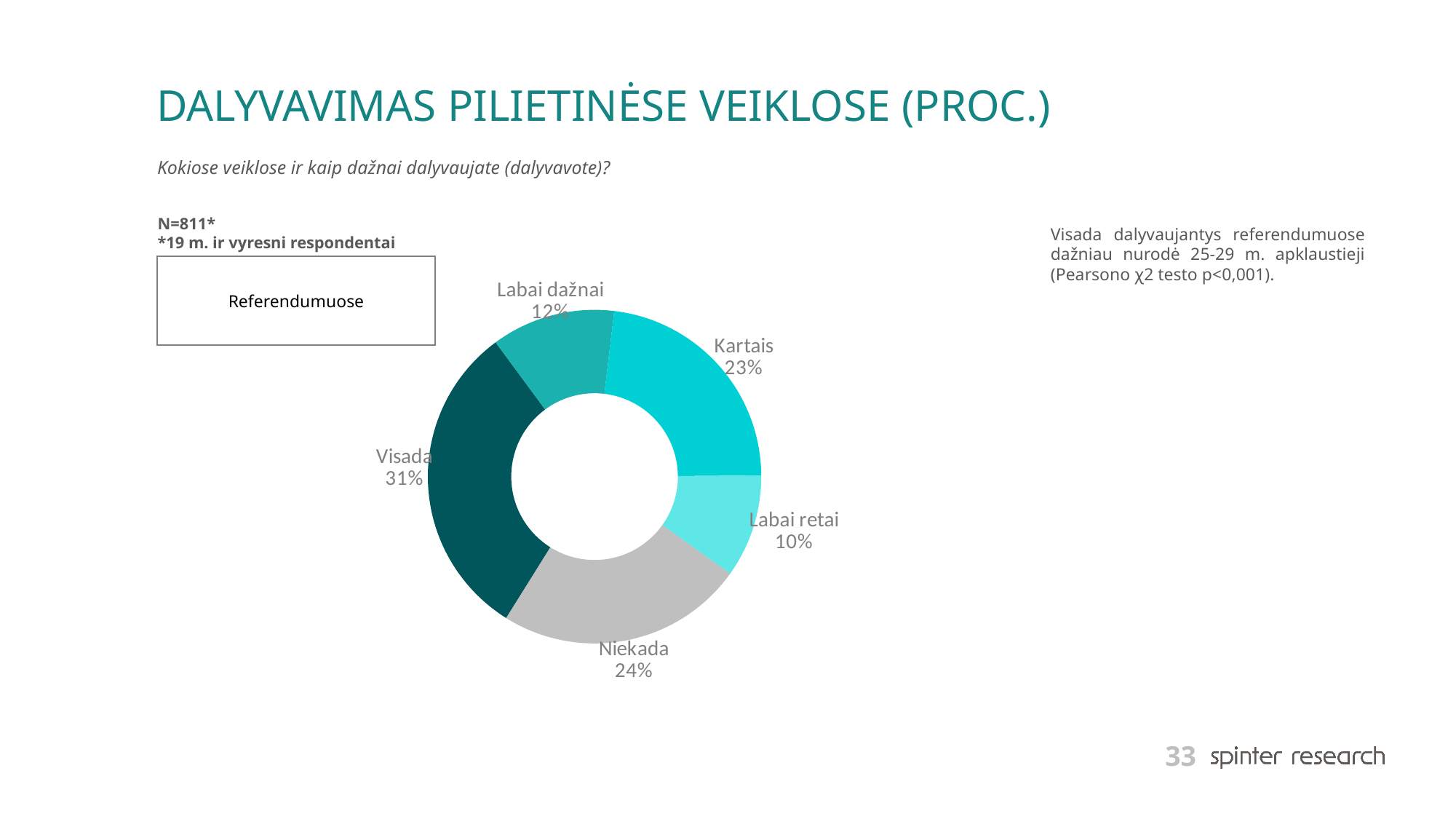
What percentage of respondents answered "Niekada" in the Referendumuose chart? 24% What is the sample size (N) stated on the slide? N=811* Which is larger in the Referendumuose chart, "Labai dažnai" or "Kartais"? Kartais What percentage of respondents answered "Kartais" in the Referendumuose chart? 23% What kind of chart is used to show participation in referendums? Pie chart (doughnut) Which category has the smallest share in the Referendumuose chart? Labai retai Which category has the largest share in the Referendumuose chart? Visada What is the combined share of "Visada" and "Labai dažnai" in the Referendumuose chart? 43% How many categories are shown in the Referendumuose chart? 5 What is the difference in percentage points between "Visada" and "Niekada" in the Referendumuose chart? 7 What percentage of respondents answered "Visada" in the Referendumuose chart? 31% What percentage of respondents answered "Labai retai" in the Referendumuose chart? 10%